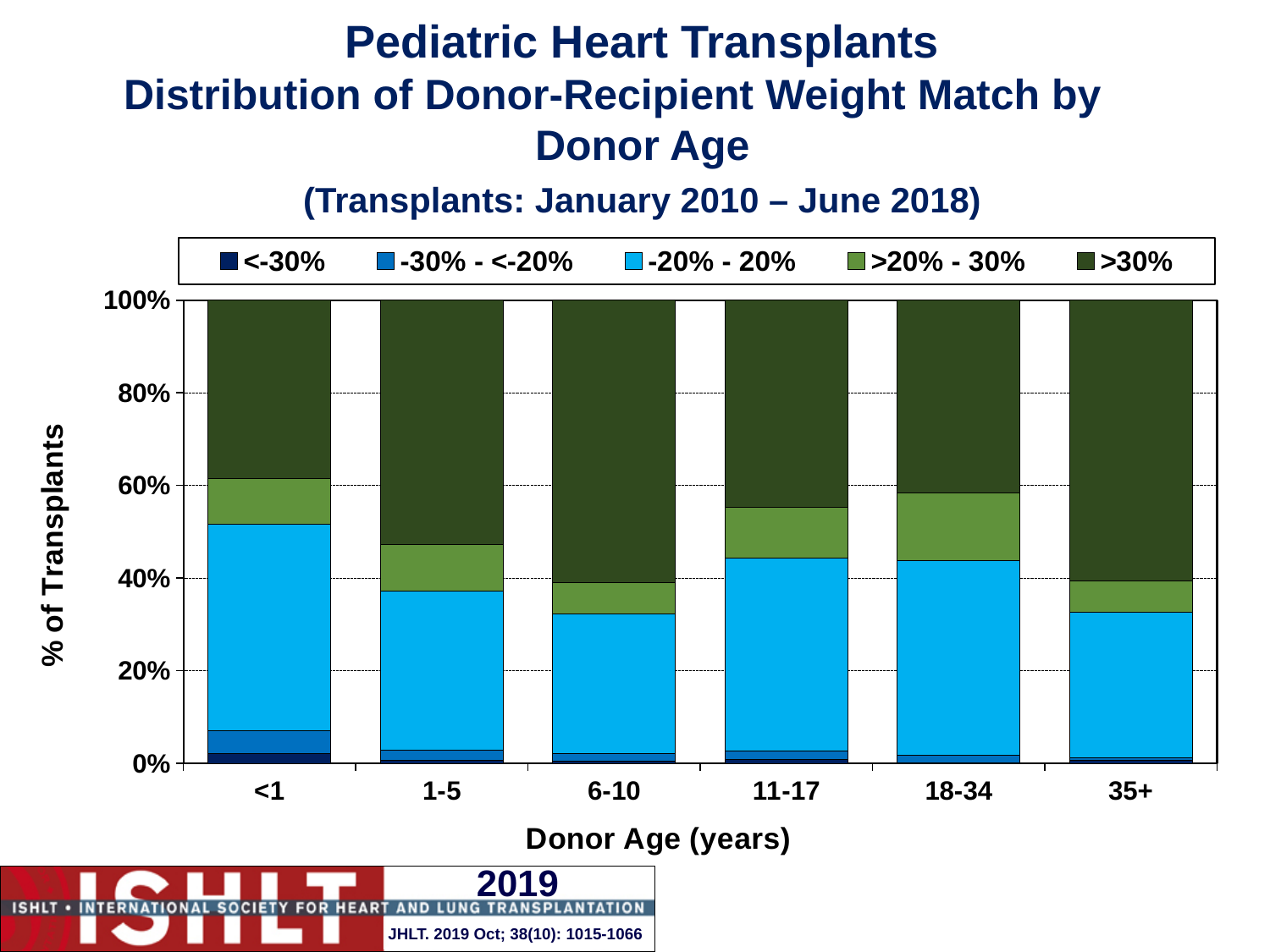
Which has the larger share of the -20% - 20% weight match category: donor age <1 or donor age 6-10? <1 Is the share of the -20% - 20% weight match category for donor age <1 greater or less than 40%? greater How many series does the legend list? 5 What is the label of the y axis? % of Transplants What kind of chart is shown on the slide? Stacked bar chart What is the total height of the stacked bar for donor age 1-5? 100% Which donor age group has the smallest share of the >30% weight match category? <1 What is the label of the x axis? Donor Age (years) Is the share of the >30% weight match category for donor age <1 greater or less than 50%? less Is the share of the -20% - 20% weight match category for donor age 35+ greater or less than 20%? greater How many donor age categories are shown on the x axis? 6